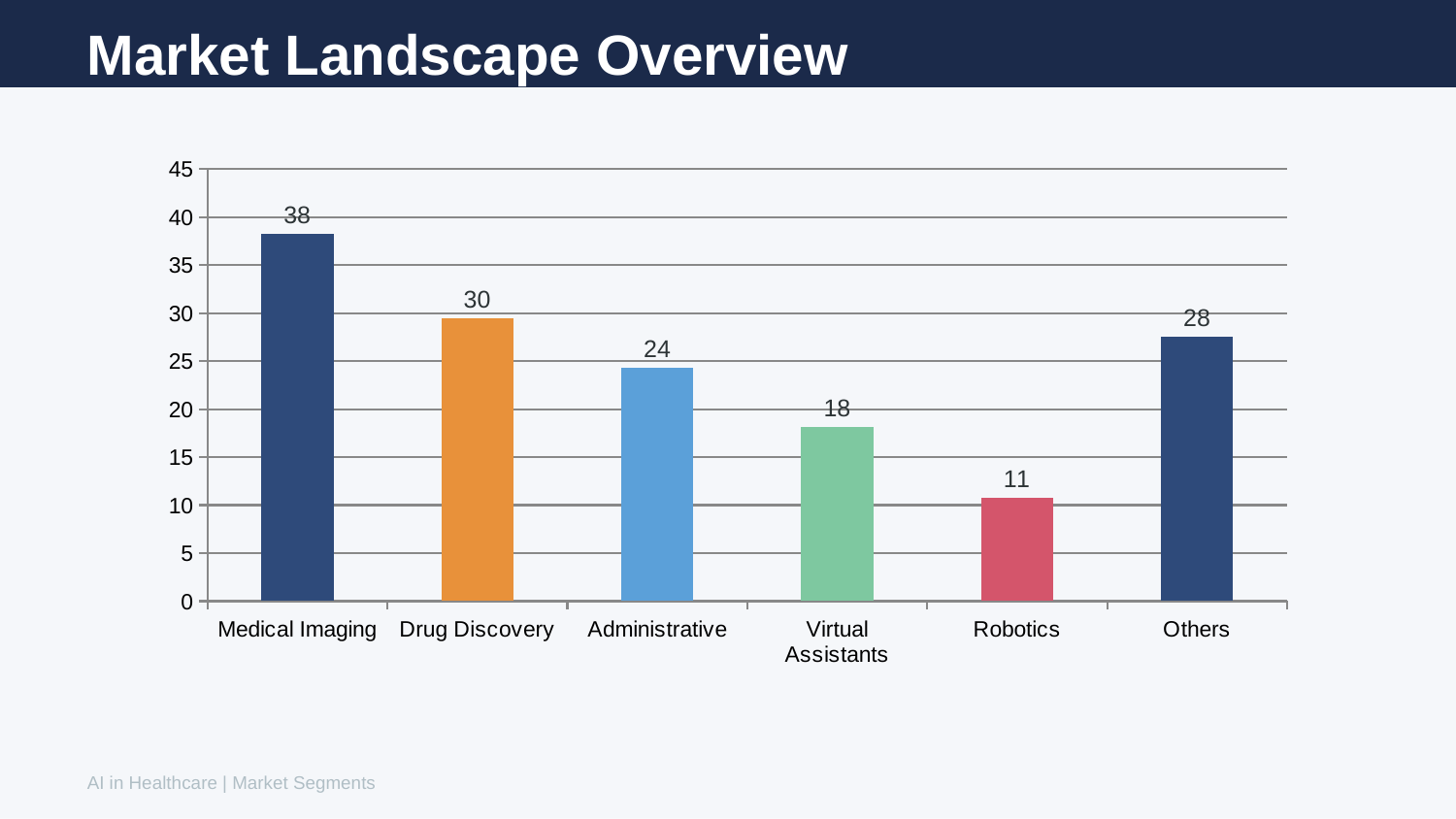
What is the title of the slide containing the chart? Market Landscape Overview What is the value for Virtual Assistants? 18 What is the difference between the values for Medical Imaging and Others? 10 What is the value for Robotics? 11 What is the value for Medical Imaging? 38 What kind of chart is shown on the slide? Bar chart Which category has the highest value? Medical Imaging How many categories are shown on the x axis? 6 What is the difference between the values for Drug Discovery and Administrative? 6 Is the value for Drug Discovery greater or less than 25? greater Which is larger, the value for Others or the value for Administrative? Others Which category has the lowest value? Robotics